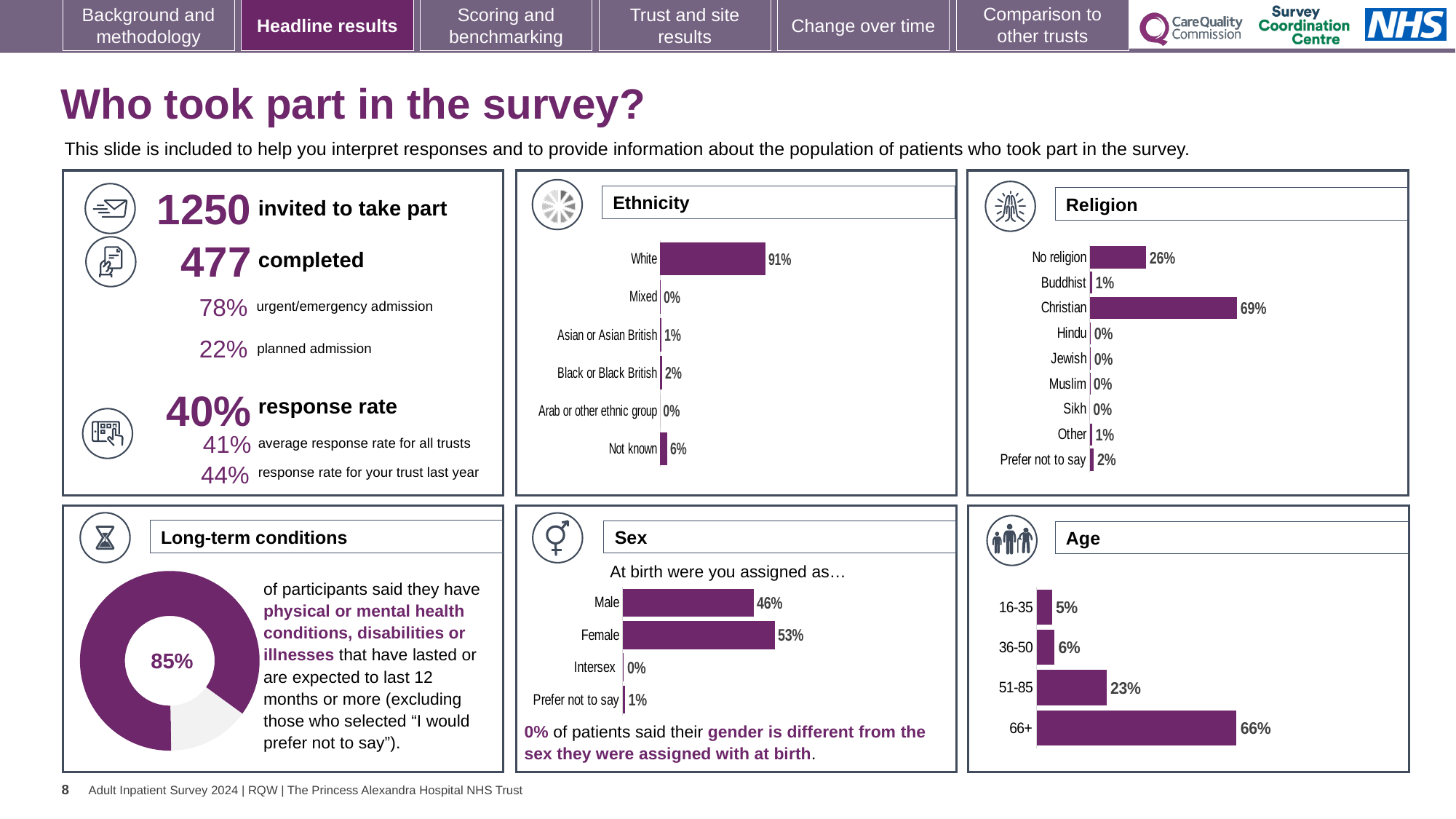
In the Religion chart, how many categories are shown? 9 In the Ethnicity chart, which category has the highest value? White In the Ethnicity chart, how many categories are shown? 6 What kind of chart is the Long-term conditions chart? Doughnut chart In the Sex chart, which is larger, Male or Female? Female In the Ethnicity chart, what percentage of respondents were White? 91% In the Religion chart, what is the difference between the Christian and No religion values? 43% In the Age chart, what percentage of respondents were aged 66+? 66% In the Sex chart, what percentage of respondents were Female? 53% In the Religion chart, what percentage of respondents were Christian? 69% In the Age chart, which age group has the lowest value? 16-35 In the Age chart, what is the difference between the 51-85 and 36-50 values? 17%